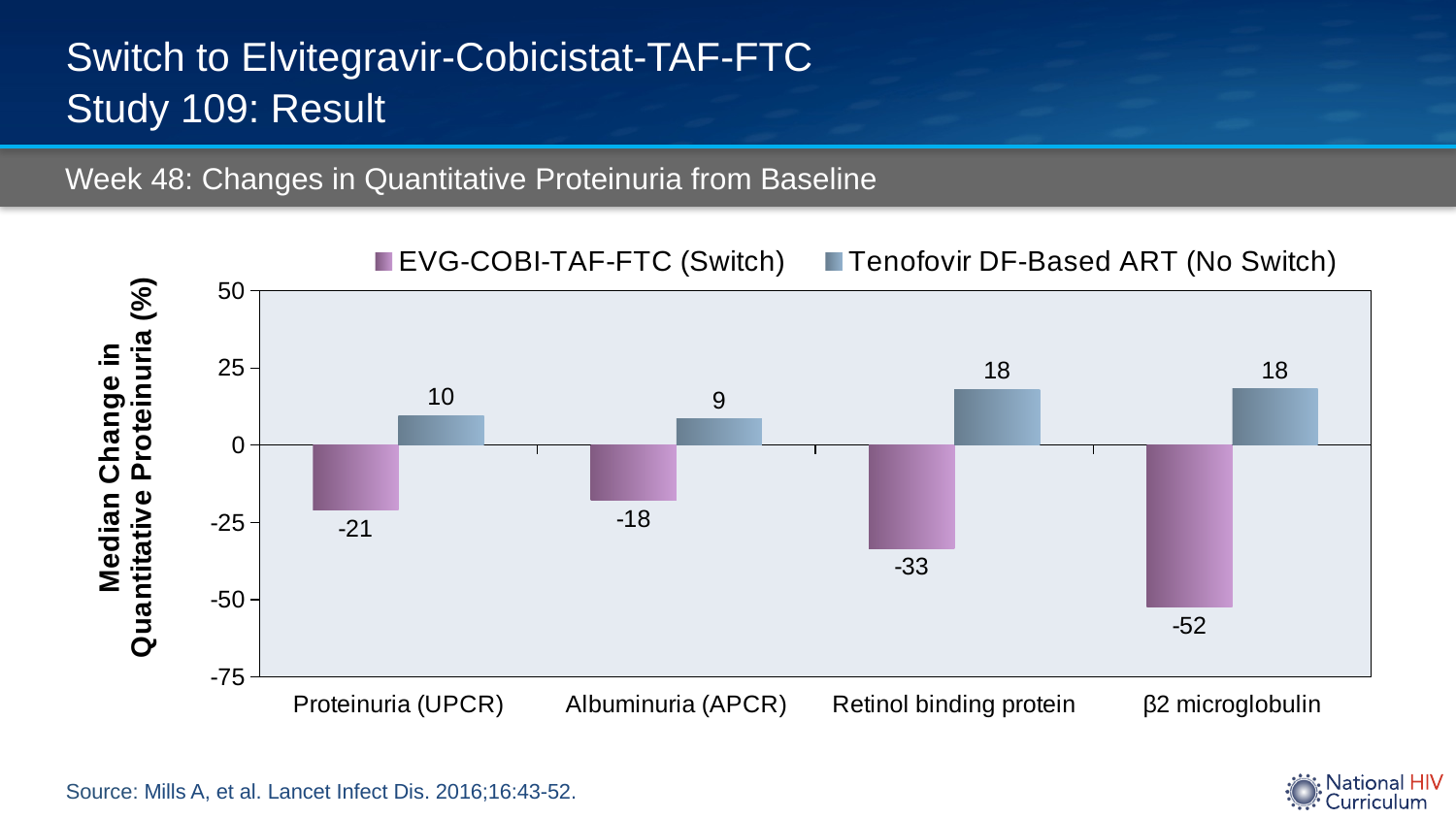
What is the label of the y axis? Median Change in Quantitative Proteinuria (%) What is the value for Tenofovir DF-Based ART (No Switch) in the Albuminuria (APCR) category? 9 What is the value for Tenofovir DF-Based ART (No Switch) in the Retinol binding protein category? 18 What is the median change in quantitative proteinuria for EVG-COBI-TAF-FTC (Switch) in the Proteinuria (UPCR) category? -21 In which category does EVG-COBI-TAF-FTC (Switch) show the highest (least negative) value? Albuminuria (APCR) Which series has the larger value for Proteinuria (UPCR): EVG-COBI-TAF-FTC (Switch) or Tenofovir DF-Based ART (No Switch)? Tenofovir DF-Based ART (No Switch) What is the difference between the Tenofovir DF-Based ART (No Switch) value and the EVG-COBI-TAF-FTC (Switch) value for Retinol binding protein? 51 In which category does EVG-COBI-TAF-FTC (Switch) show the lowest (most negative) value? β2 microglobulin What is the value for EVG-COBI-TAF-FTC (Switch) in the β2 microglobulin category? -52 How many series does the legend list? 2 What kind of chart is shown on the slide? Bar chart How many categories are shown on the x axis of the chart? 4